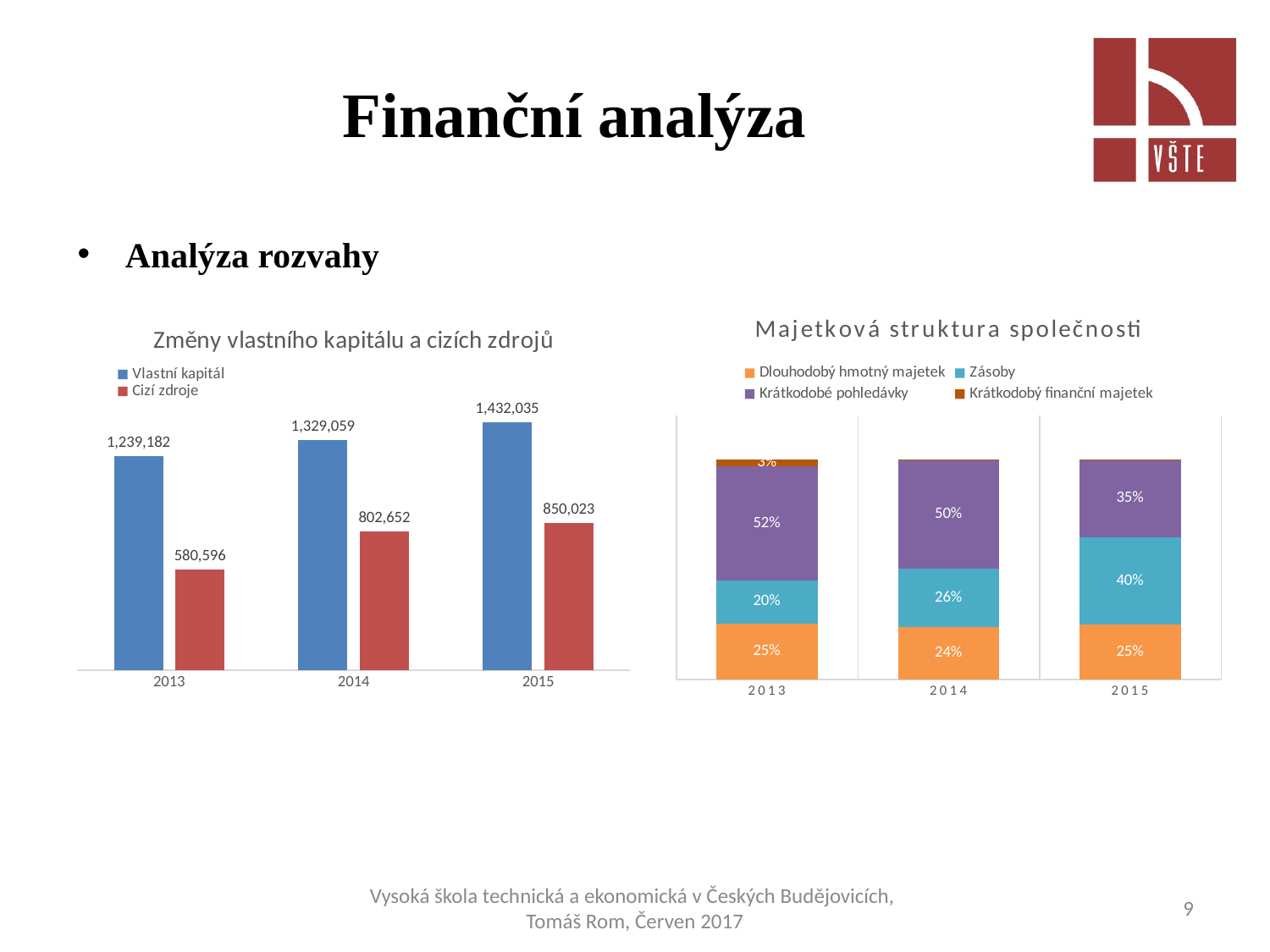
In the chart 'Změny vlastního kapitálu a cizích zdrojů', how many series does the legend list? 2 What kind of chart is 'Změny vlastního kapitálu a cizích zdrojů'? bar chart In the chart 'Změny vlastního kapitálu a cizích zdrojů', what is the difference between Vlastní kapitál and Cizí zdroje in 2014? 526,407 In the chart 'Majetková struktura společnosti', what is the total of the stacked bar for 2014? 100% In the chart 'Majetková struktura společnosti', what is the share of Zásoby in 2015? 40% In the chart 'Změny vlastního kapitálu a cizích zdrojů', what is the value of Vlastní kapitál for 2015? 1,432,035 In the chart 'Změny vlastního kapitálu a cizích zdrojů', does Vlastní kapitál rise or fall from 2013 to 2015? rise In the chart 'Majetková struktura společnosti', how many series does the legend list? 4 In the chart 'Majetková struktura společnosti', what is the share of Krátkodobé pohledávky in 2014? 50% In the chart 'Změny vlastního kapitálu a cizích zdrojů', what is the value of Cizí zdroje for 2013? 580,596 In the chart 'Majetková struktura společnosti', which is larger in 2013: Zásoby or Krátkodobé pohledávky? Krátkodobé pohledávky In the chart 'Změny vlastního kapitálu a cizích zdrojů', which year has the lowest value of Cizí zdroje? 2013